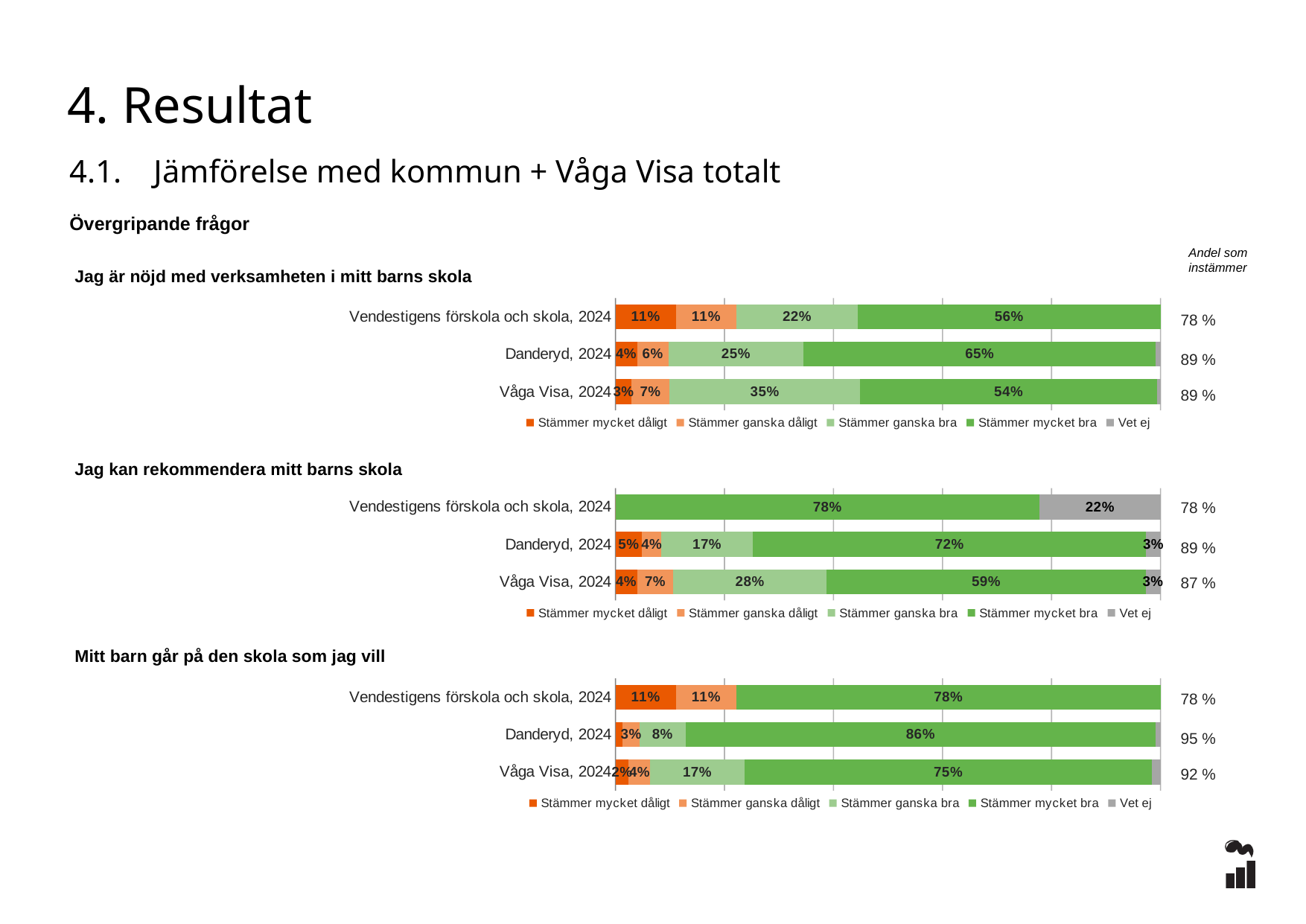
In the chart 'Mitt barn går på den skola som jag vill', which row has the lowest 'Stämmer mycket bra' value? Våga Visa, 2024 In the chart 'Jag är nöjd med verksamheten i mitt barns skola', what is the difference between the 'Stämmer mycket bra' values for Danderyd, 2024 and Vendestigens förskola och skola, 2024? 9 percentage points In the chart 'Jag kan rekommendera mitt barns skola', which is larger: the 'Stämmer ganska bra' value for Danderyd, 2024 or for Våga Visa, 2024? Våga Visa, 2024 In the chart 'Jag kan rekommendera mitt barns skola', what is the 'Vet ej' value for Vendestigens förskola och skola, 2024? 22% In the chart 'Jag är nöjd med verksamheten i mitt barns skola', what is the 'Stämmer ganska bra' value for Våga Visa, 2024? 35% What kind of chart is 'Jag är nöjd med verksamheten i mitt barns skola'? Stacked bar chart How many series does the legend list for the chart 'Jag kan rekommendera mitt barns skola'? 5 In the chart 'Mitt barn går på den skola som jag vill', what is the 'Stämmer mycket bra' value for Danderyd, 2024? 86% In the chart 'Jag är nöjd med verksamheten i mitt barns skola', what is the 'Stämmer mycket bra' value for Vendestigens förskola och skola, 2024? 56% In the chart 'Jag är nöjd med verksamheten i mitt barns skola', which row has the highest 'Stämmer mycket bra' value? Danderyd, 2024 In the chart 'Jag kan rekommendera mitt barns skola', what is the 'Stämmer mycket bra' value for Danderyd, 2024? 72% In the chart 'Mitt barn går på den skola som jag vill', what is the 'Andel som instämmer' value shown for Danderyd, 2024? 95 %